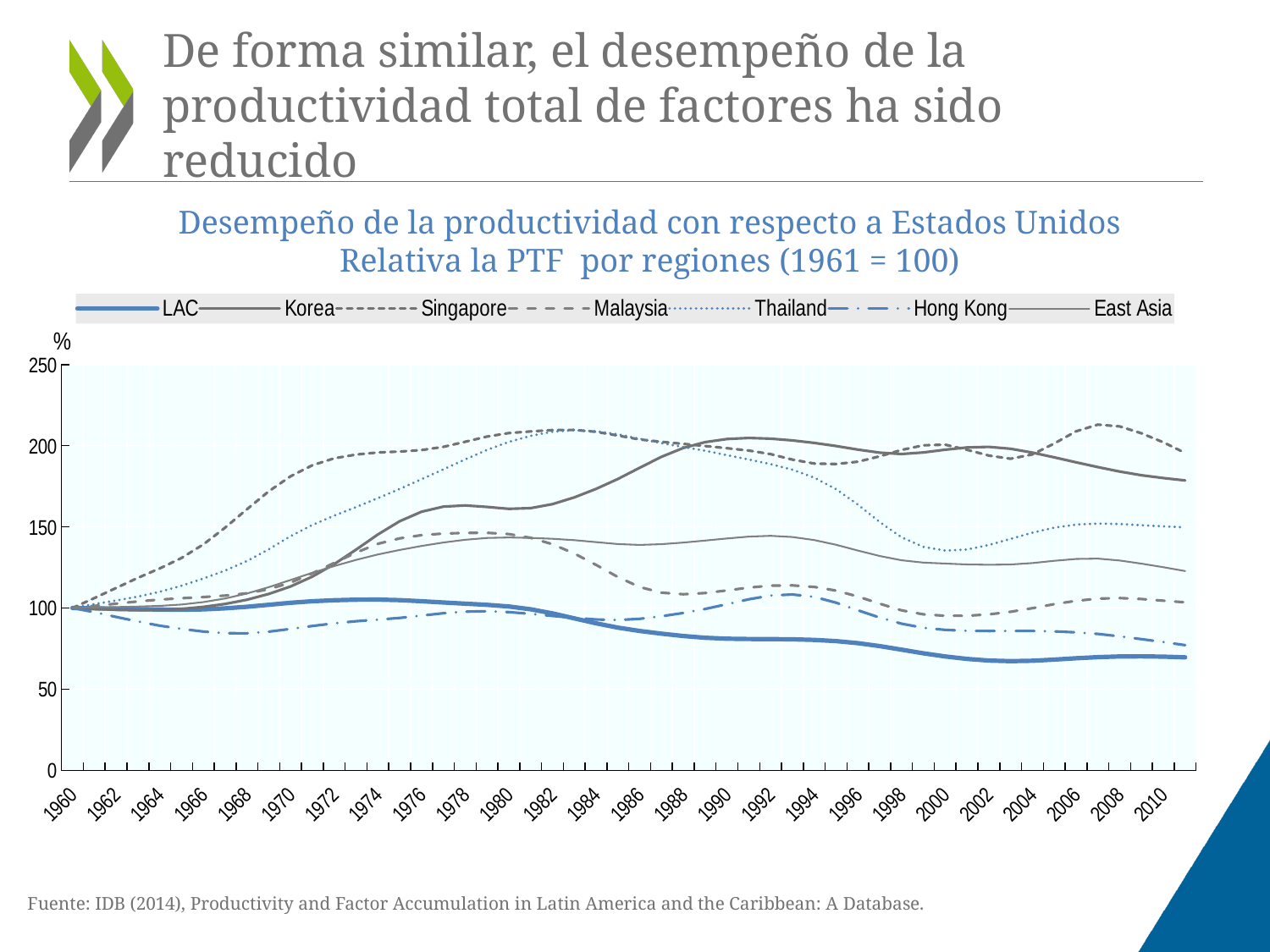
Is the value for Hong Kong in 2010 greater or less than 100? less What unit is shown on the y axis? % Is the value for LAC in 2010 greater or less than 100? less Is the value for Singapore in 2008 greater or less than 200? greater Which series has the highest value in 2010? Singapore Does the LAC series rise or fall from 1960 to 2010? fall How many series does the legend list? 7 Which series has the lowest value in 1966? Hong Kong What kind of chart is shown on the slide? line chart What is the value for LAC in 1960? 100 In 2010, which is larger, the value for Korea or the value for Thailand? Korea